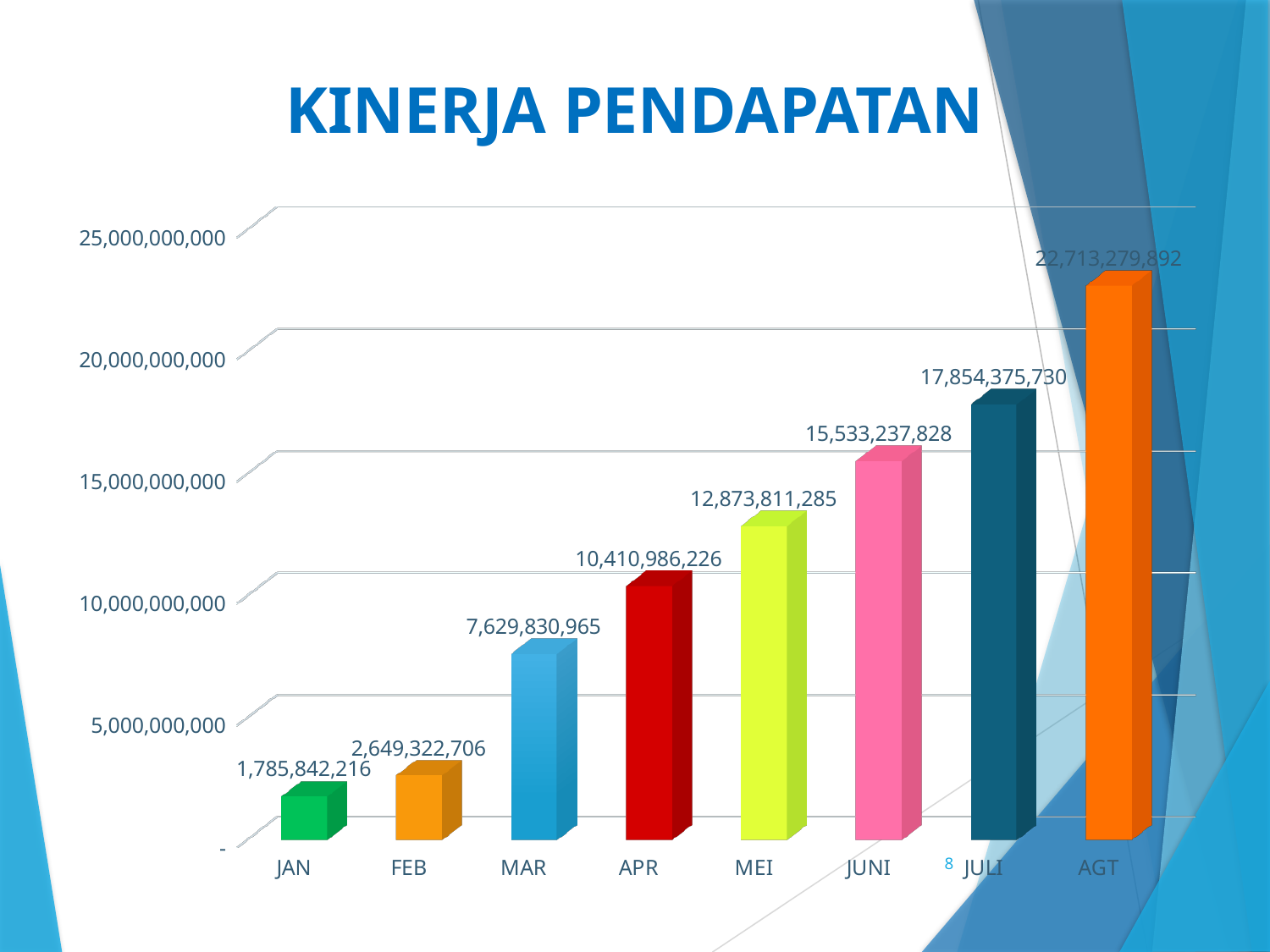
Is the value for JULI greater or less than 20,000,000,000? less What kind of chart is shown on the slide? bar chart Which month has the lowest value? JAN How many months are shown on the x axis? 8 What is the difference between the values for AGT and JULI? 4,858,904,162 What is the value for JUNI? 15,533,237,828 What is the value for JAN? 1,785,842,216 What is the difference between the values for FEB and JAN? 863,480,490 Which month has the highest value? AGT Which is larger, the value for APR or the value for MEI? MEI Do the values rise or fall from JAN to AGT? rise What is the value for MAR? 7,629,830,965